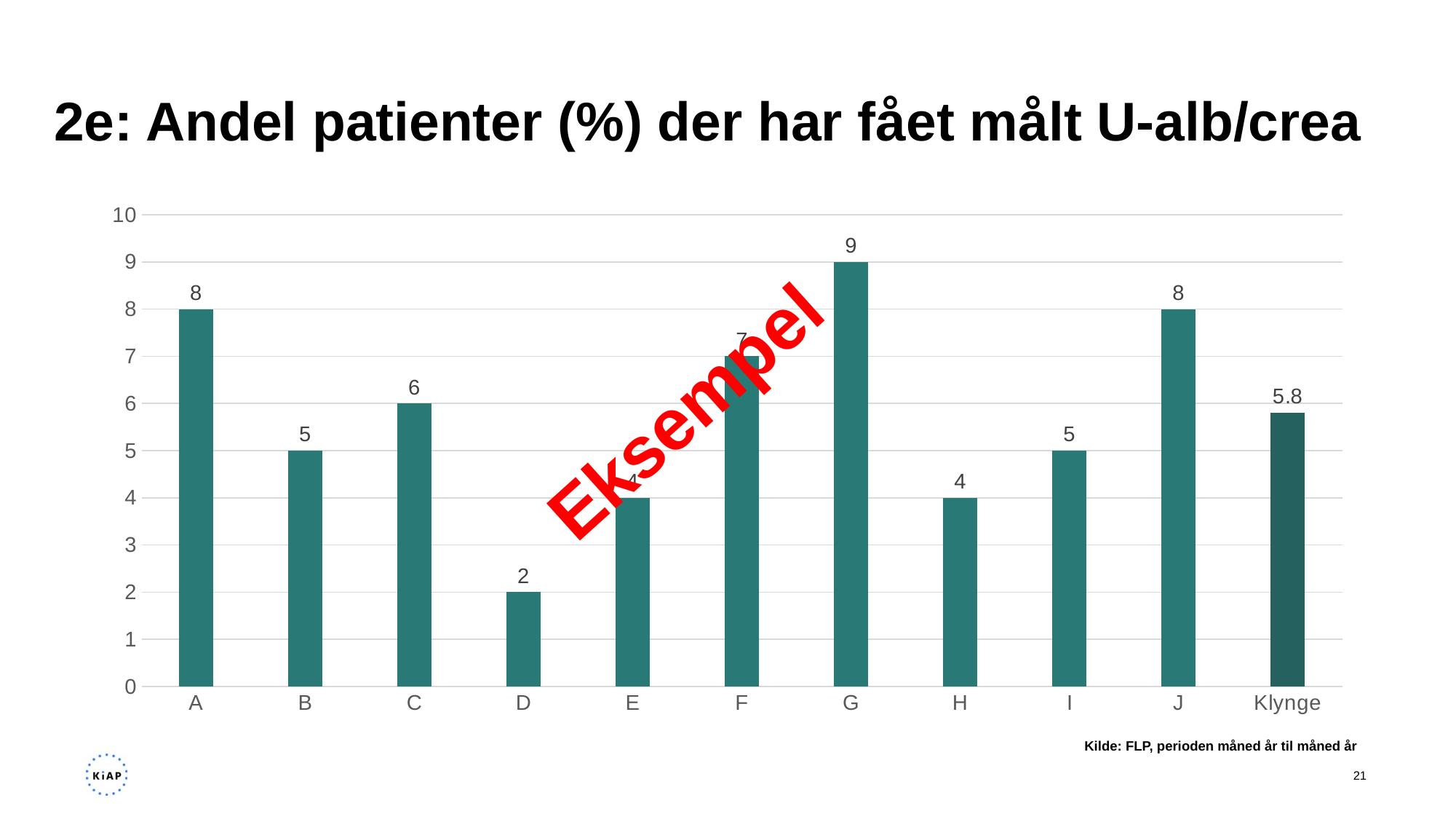
What is the difference between the values for A and B? 3 What is the value for D? 2 What is the title of the slide? 2e: Andel patienter (%) der har fået målt U-alb/crea What kind of chart is shown on the slide? Bar chart Which category has the lowest value? D Is the value for J greater or less than 5? greater What is the value for G? 9 What is the difference between the values for G and D? 7 How many categories are shown on the x axis? 11 Which category has the highest value? G What is the value for Klynge? 5.8 Which is larger, the value for C or the value for H? C